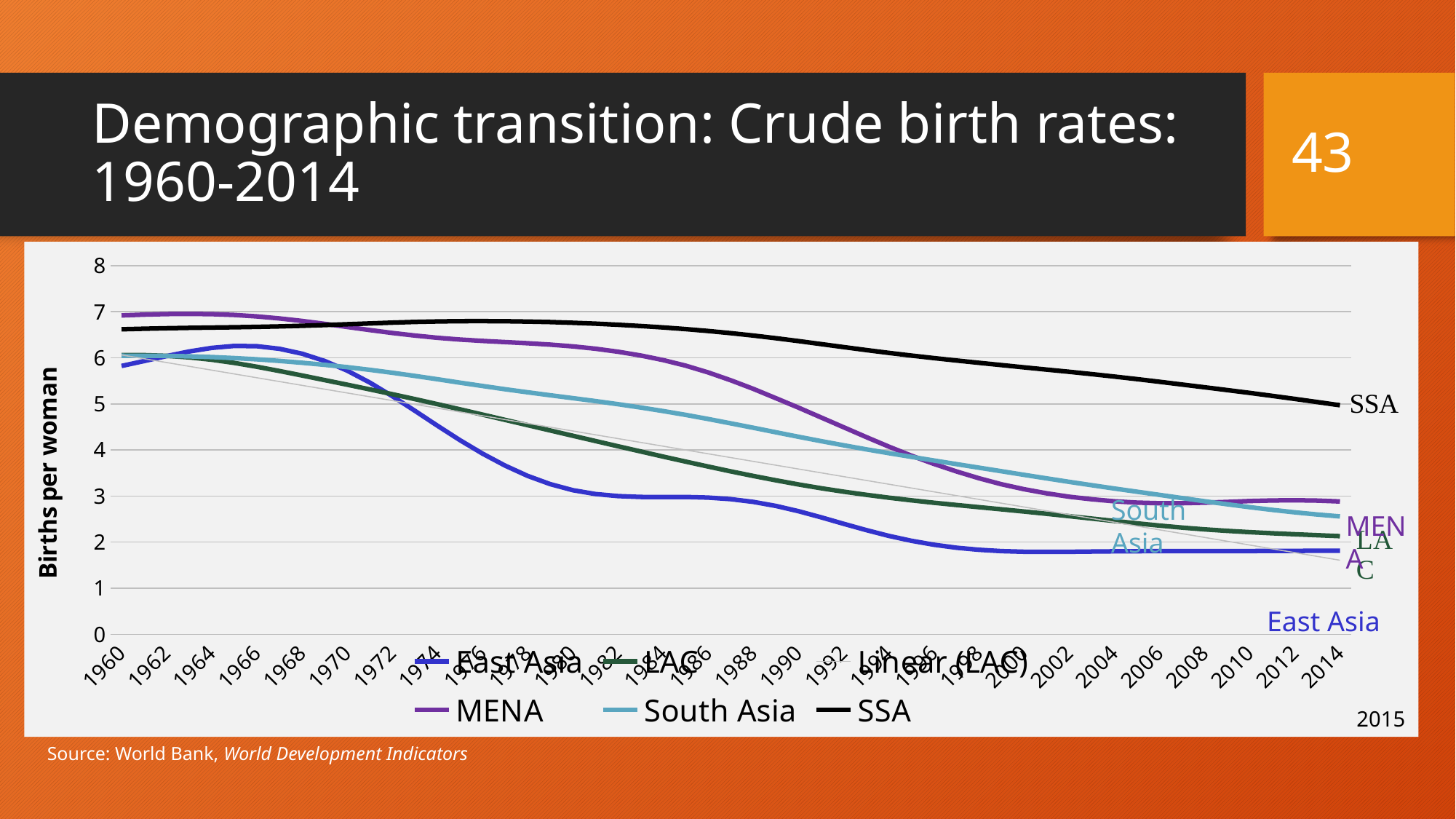
In 1960, which is higher: MENA or East Asia? MENA How many series does the legend list? 6 Is the value for East Asia in 2014 greater or less than 3? less Which region has the highest births per woman in 2014? SSA Does the East Asia line rise or fall from 1966 to 2014? fall Is the value for MENA in 1960 greater or less than 6? greater What is the label of the vertical axis? Births per woman What kind of chart is shown on the slide? line chart What is the title of the slide containing the chart? Demographic transition: Crude birth rates: 1960-2014 Is the value for SSA in 2014 greater or less than 4? greater Does the SSA line rise or fall from 1960 to 2014? fall Which region has the lowest births per woman in 2014? East Asia